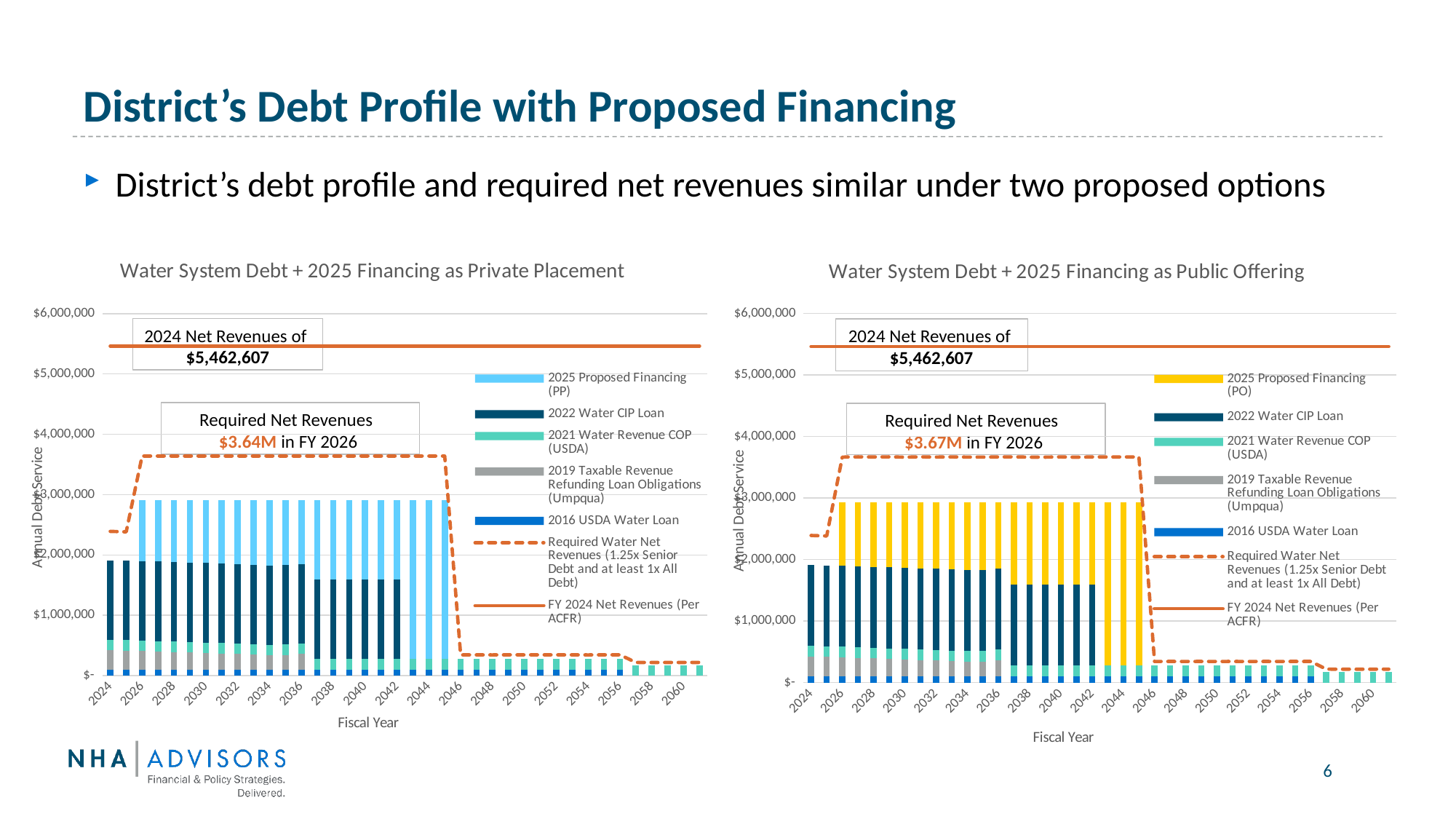
In the left chart (Private Placement), what are the Required Net Revenues in FY 2026? $3.64M In the left chart (Private Placement), is the total annual debt service for fiscal year 2030 greater or less than $2,000,000? greater Which option shows the higher Required Net Revenues in FY 2026, the Private Placement chart or the Public Offering chart? Public Offering In the left chart (Private Placement), what is the highest value shown on the y axis? $6,000,000 In the left chart (Private Placement), what are the 2024 Net Revenues shown in the annotation? $5,462,607 What is the x-axis title of the left chart (Private Placement)? Fiscal Year In the right chart (Public Offering), does the Required Water Net Revenues dashed line rise or fall between 2044 and 2046? fall In the right chart (Public Offering), what are the Required Net Revenues in FY 2026? $3.67M In the right chart (Public Offering), is the total annual debt service for fiscal year 2050 greater or less than $1,000,000? less What kind of chart is the left chart, 'Water System Debt + 2025 Financing as Private Placement'? combination bar and line chart How many entries does the legend of the right chart, 'Water System Debt + 2025 Financing as Public Offering', list? 7 In the right chart (Public Offering), what colour represents the 2025 Proposed Financing (PO) series? yellow